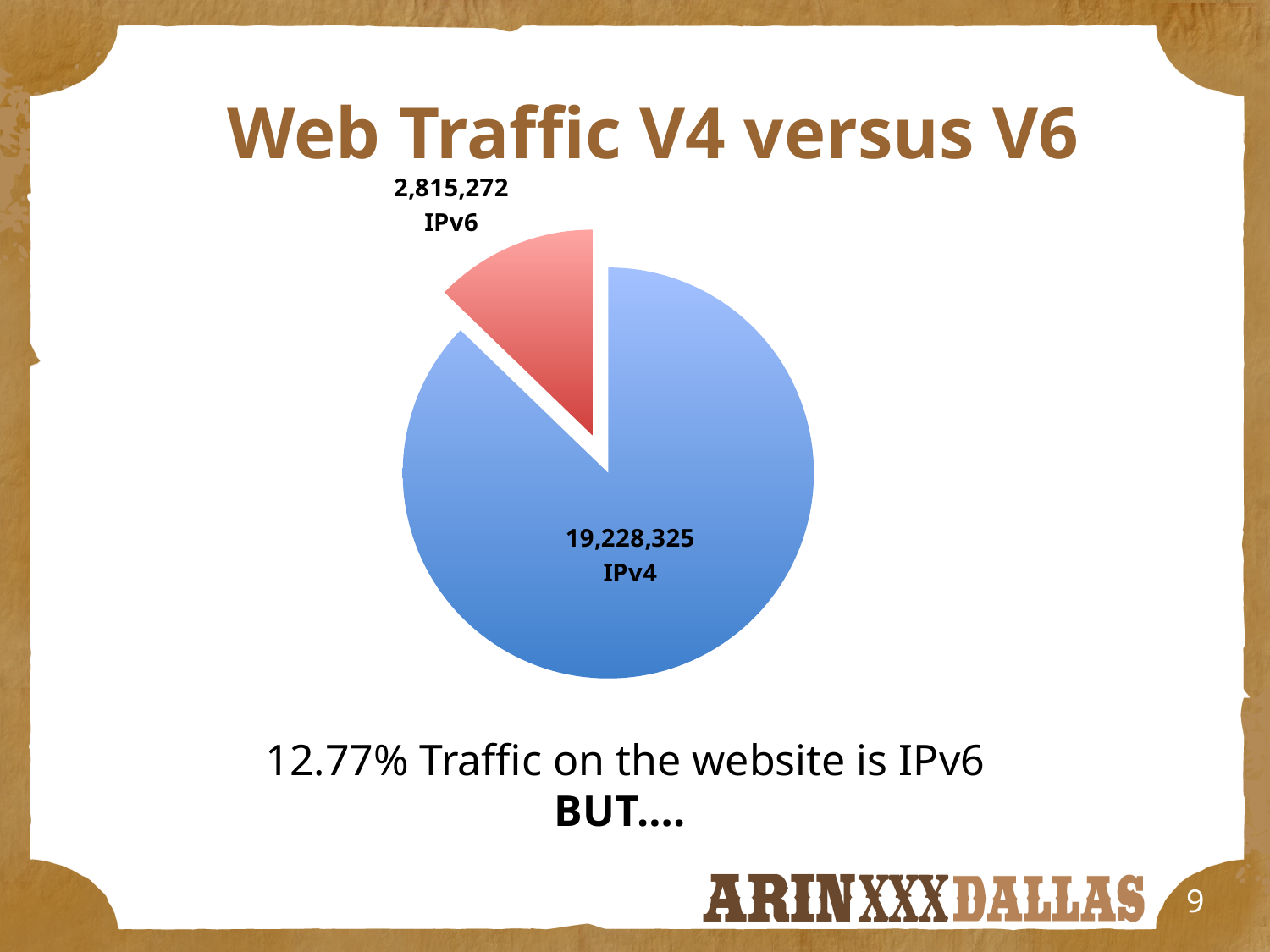
What is the value for IPv6 in the pie chart? 2,815,272 Which is larger, the IPv4 value or the IPv6 value? IPv4 What type of chart is shown on the slide? pie chart Which slice of the pie chart is the smallest? IPv6 What share of the pie does IPv6 represent? 12.77% What is the total of the two slices in the pie chart? 22,043,597 What is the difference between the IPv4 value and the IPv6 value? 16,413,053 Which slice of the pie chart is the largest? IPv4 How many slices does the pie chart have? 2 What is the value for IPv4 in the pie chart? 19,228,325 What colour is the IPv6 slice in the pie chart? red What is the title of the slide containing the pie chart? Web Traffic V4 versus V6